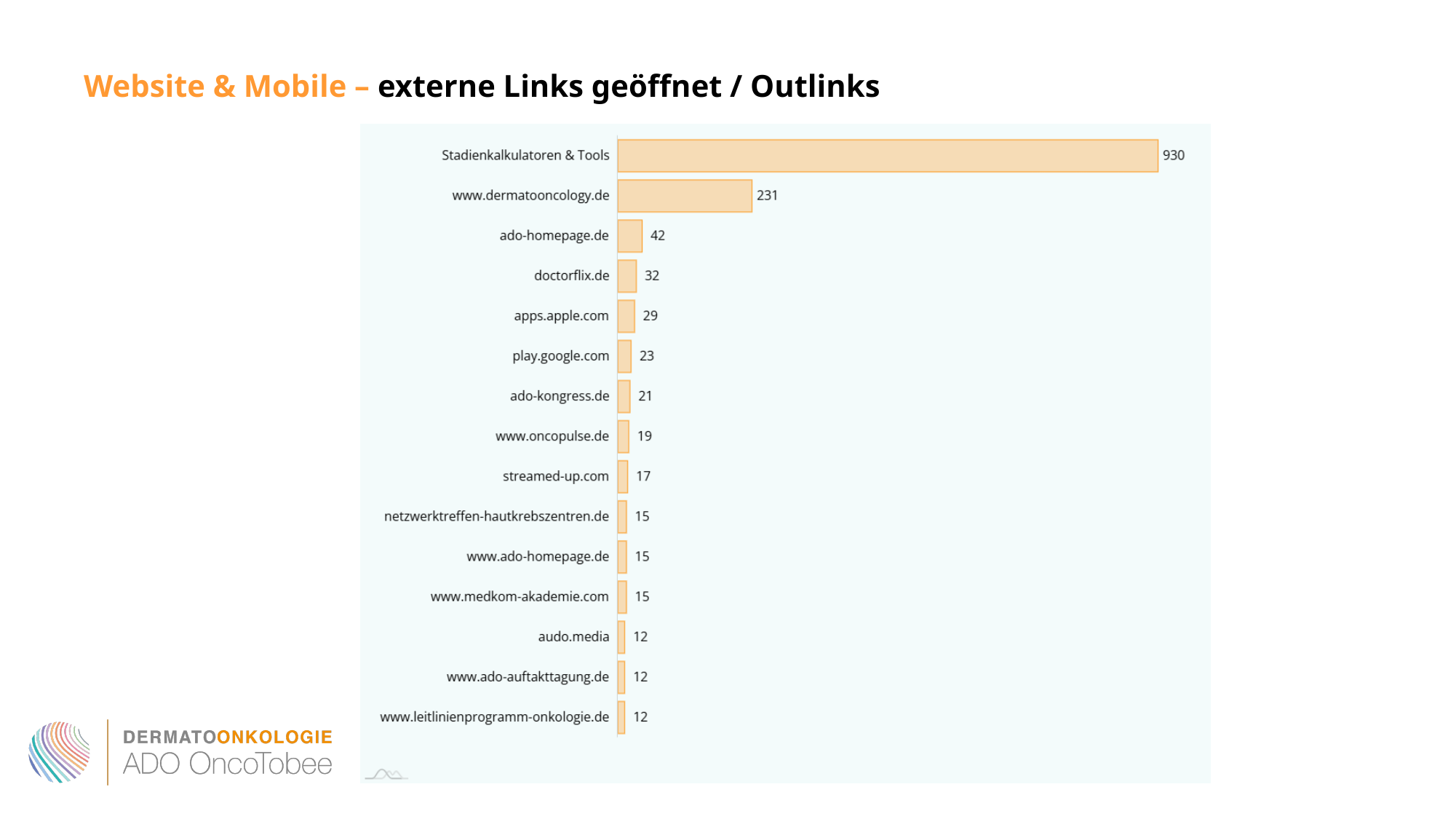
What is the difference between the values for Stadienkalkulatoren & Tools and www.dermatooncology.de? 699 What is the difference between the values for ado-homepage.de and apps.apple.com? 13 What is the value for Stadienkalkulatoren & Tools? 930 What is the value for www.dermatooncology.de? 231 Which is larger, the value for ado-homepage.de or the value for doctorflix.de? ado-homepage.de How many categories are shown in the chart? 15 Which category has the highest value? Stadienkalkulatoren & Tools Which is larger, the value for apps.apple.com or the value for www.oncopulse.de? apps.apple.com What is the value for play.google.com? 23 What is the value for doctorflix.de? 32 What kind of chart is shown on the slide? Bar chart What is the value for streamed-up.com? 17